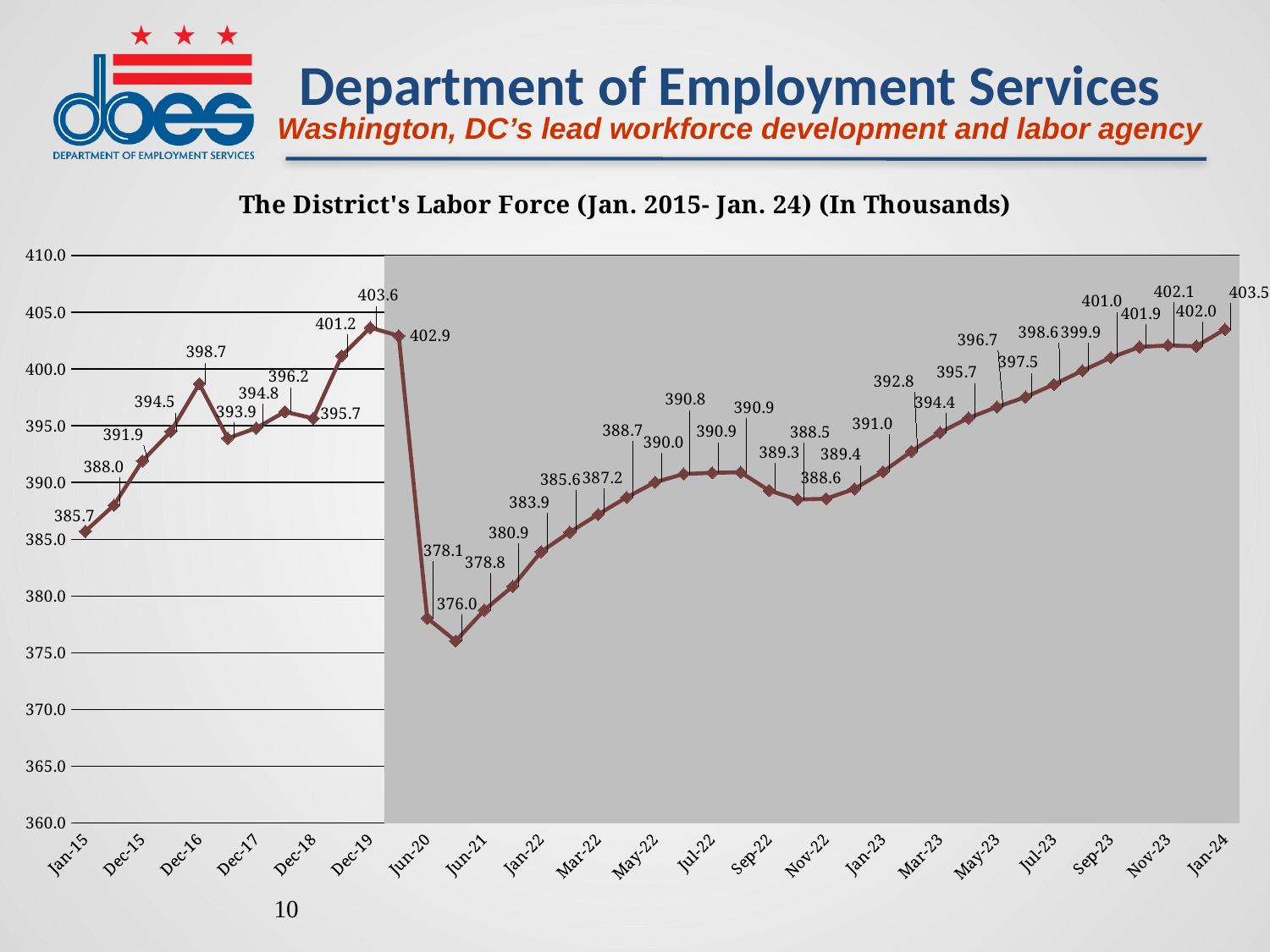
Which labeled month on the x axis has the highest labor force value? Dec-19 What is the labor force value for Jan-24? 403.5 What type of chart is shown on the slide? line chart What is the lowest value plotted on the chart? 376.0 Is the value for Jun-20 greater or less than 380.0? less What is the labor force value for Jun-20? 378.1 What is the difference between the Jan-24 value and the Jan-15 value? 17.8 What is the title of the chart? The District's Labor Force (Jan. 2015- Jan. 24) (In Thousands) What is the labor force value for Dec-19? 403.6 Does the labor force rise or fall from Jun-21 to Jan-24? rise What is the labor force value for Jan-15? 385.7 Which is larger, the value for Dec-16 or the value for Dec-17? Dec-16